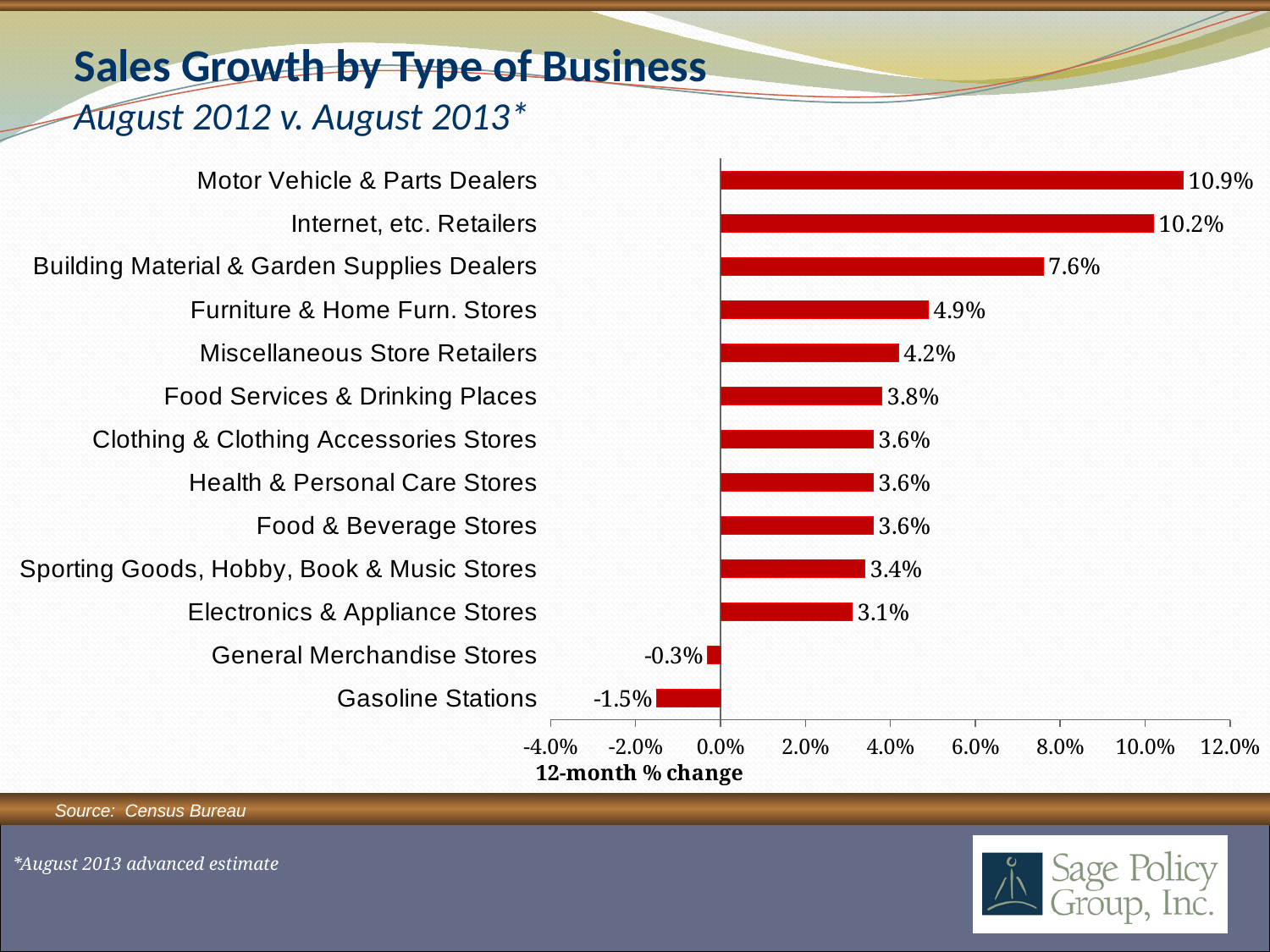
What is the 12-month % change for Motor Vehicle & Parts Dealers? 10.9% Which type of business has the lowest sales growth? Gasoline Stations Is the value for Electronics & Appliance Stores greater or less than 4.0%? less What is the difference between the values for Motor Vehicle & Parts Dealers and Internet, etc. Retailers? 0.7% Which type of business has the highest sales growth? Motor Vehicle & Parts Dealers What is the label of the horizontal axis? 12-month % change What kind of chart is shown on the slide? Bar chart What is the 12-month % change for Gasoline Stations? -1.5% How many types of business show a negative 12-month % change? 2 What is the 12-month % change for Building Material & Garden Supplies Dealers? 7.6% Which has a larger 12-month % change, Furniture & Home Furn. Stores or Miscellaneous Store Retailers? Furniture & Home Furn. Stores How many types of business are shown in the chart? 13